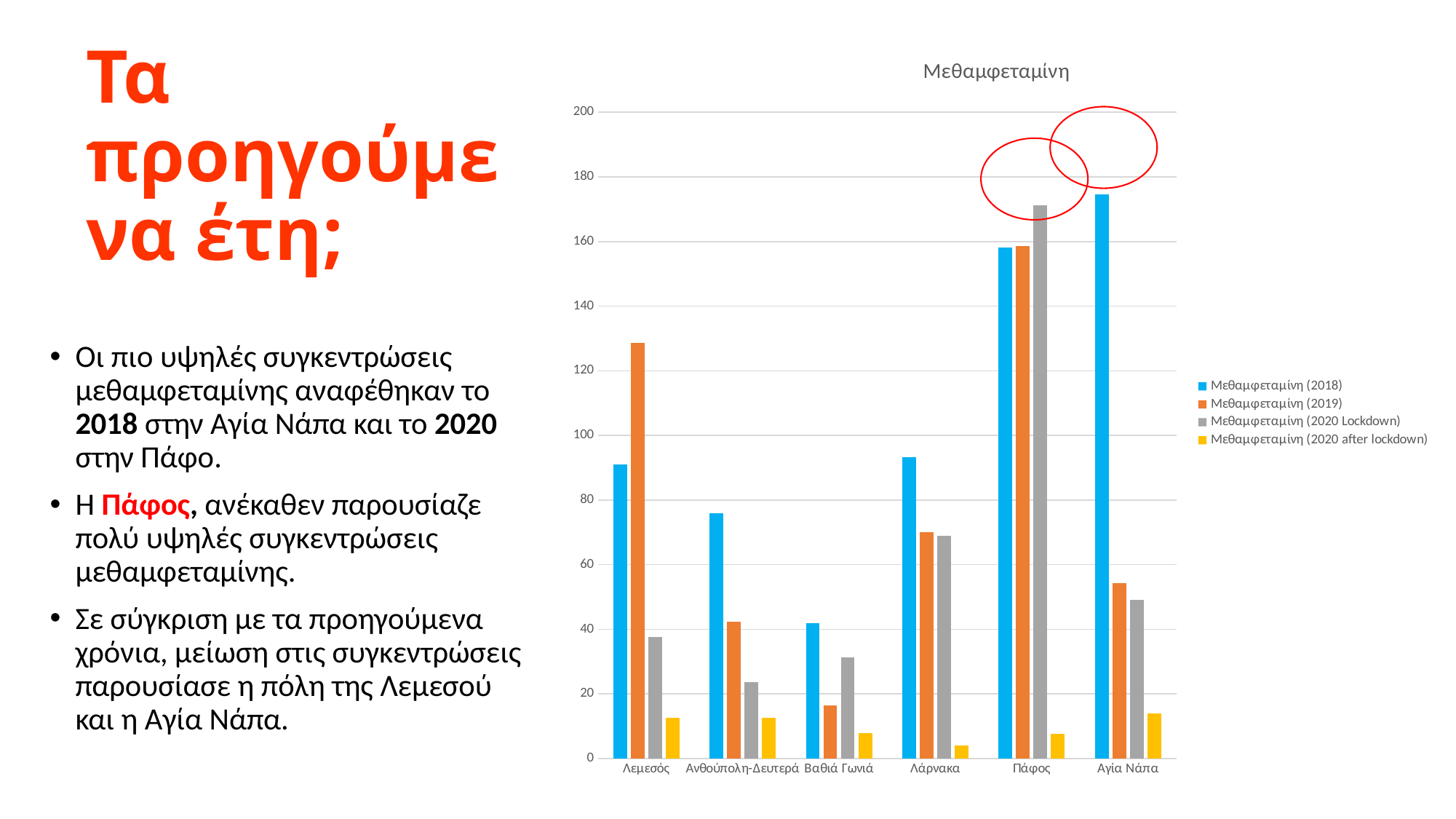
What is the title of the chart? Μεθαμφεταμίνη For the Μεθαμφεταμίνη (2020 Lockdown) series, which is larger: Πάφος or Αγία Νάπα? Πάφος What kind of chart is shown on the slide? bar chart How many categories (locations) are shown on the x axis of the chart? 6 How many series does the chart's legend list? 4 Is the Μεθαμφεταμίνη (2018) value for Λάρνακα greater or less than 100? less Which location has the lowest value for the Μεθαμφεταμίνη (2018) series? Βαθιά Γωνιά Is the Μεθαμφεταμίνη (2018) value for Αγία Νάπα greater or less than 160? greater For Λεμεσός, which is larger: the Μεθαμφεταμίνη (2018) value or the Μεθαμφεταμίνη (2019) value? Μεθαμφεταμίνη (2019) Which location has the highest value for the Μεθαμφεταμίνη (2020 Lockdown) series? Πάφος Which location has the highest value for the Μεθαμφεταμίνη (2018) series? Αγία Νάπα Is the Μεθαμφεταμίνη (2019) value for Λεμεσός greater or less than 120? greater